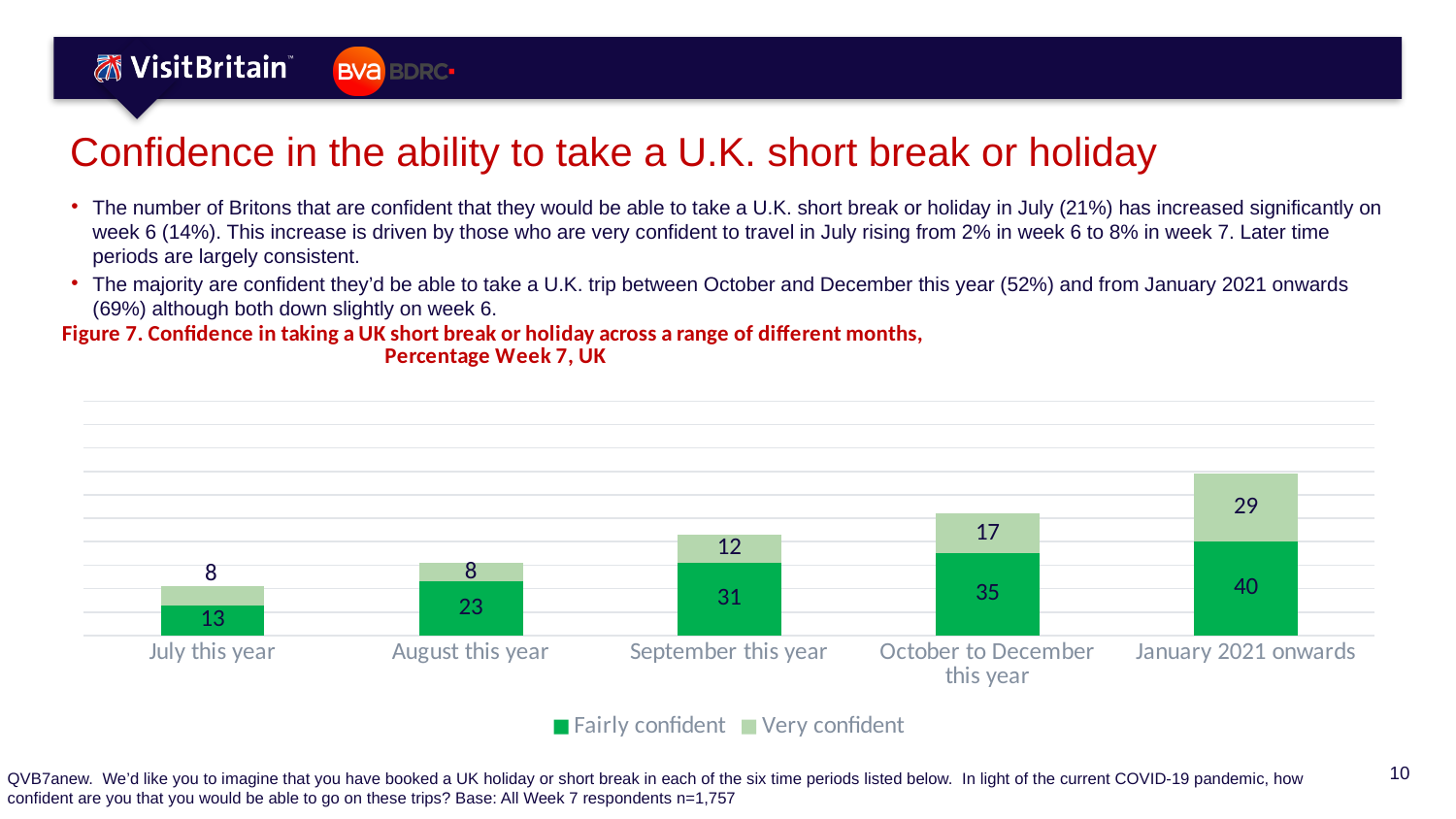
What is the total of the stacked bar for January 2021 onwards? 69 What is the value for Very confident for January 2021 onwards? 29 How many time periods are shown on the x axis? 5 Which is larger: the Very confident value for September this year or for October to December this year? October to December this year Which time period has the lowest Fairly confident value? July this year Which time period has the highest Fairly confident value? January 2021 onwards What is the value for Very confident for October to December this year? 17 What is the value for Fairly confident for July this year? 13 How many series does the legend list? 2 What kind of chart is shown? Stacked bar chart What is the difference between the Fairly confident values for September this year and August this year? 8 Do the Fairly confident values rise or fall from July this year to January 2021 onwards? Rise